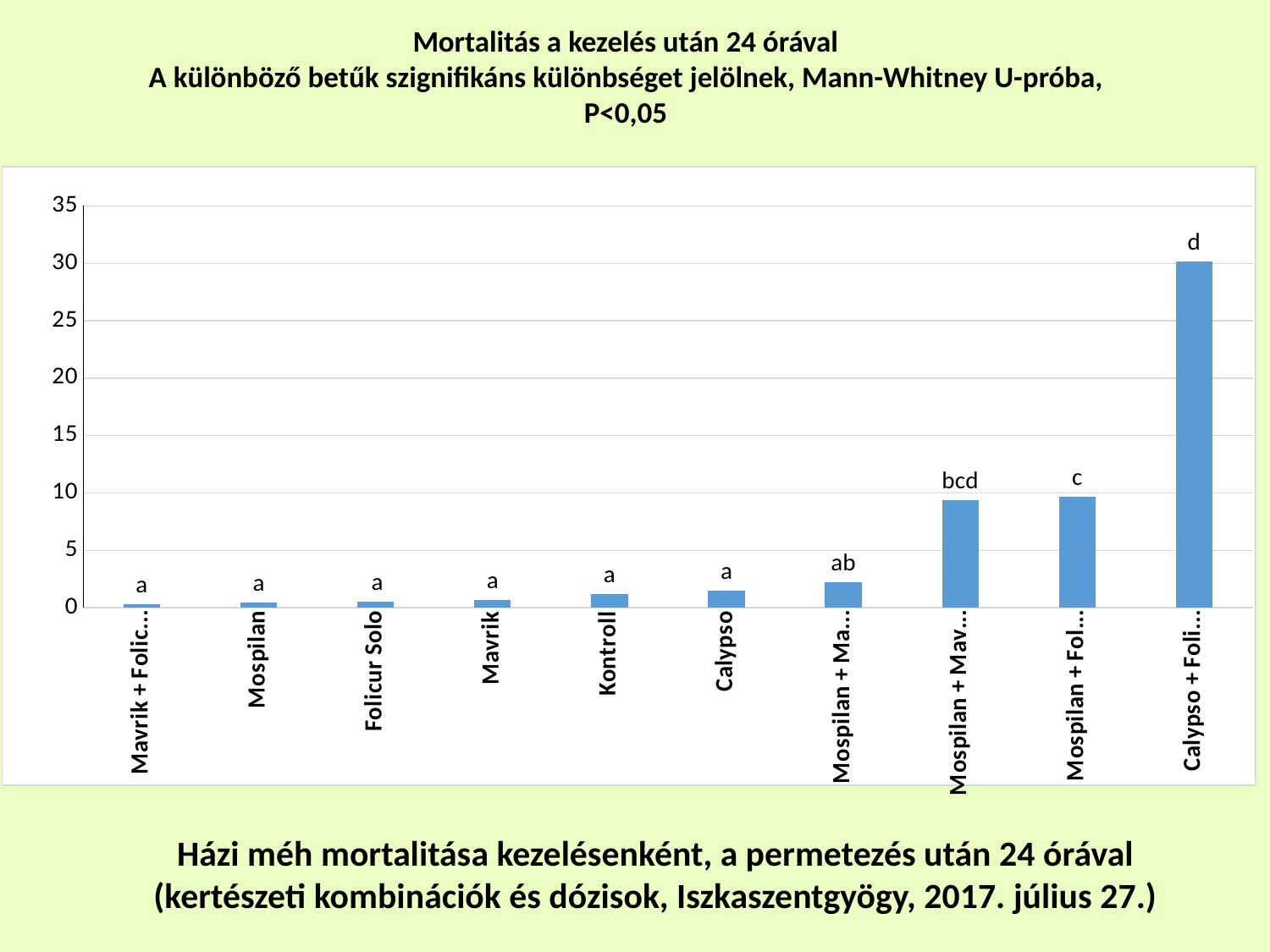
What significance letter is printed above the bar for Mospilan + Mav...? bcd Which category has the highest bar? Calypso + Foli... What is the first line of the chart title? Mortalitás a kezelés után 24 órával Do the bar values generally rise or fall from left to right along the x axis? rise How many categories (treatments) are plotted on the x axis? 10 Is the value for Calypso + Foli... greater or less than 25? greater Which is larger, the value for Calypso + Foli... or the value for Mospilan + Fol...? Calypso + Foli... Is the value for Kontroll greater or less than 5? less What kind of chart is shown on the slide? bar chart Which is larger, the value for Mospilan + Ma... or the value for Mospilan? Mospilan + Ma... Is the value for Mospilan + Fol... greater or less than 5? greater